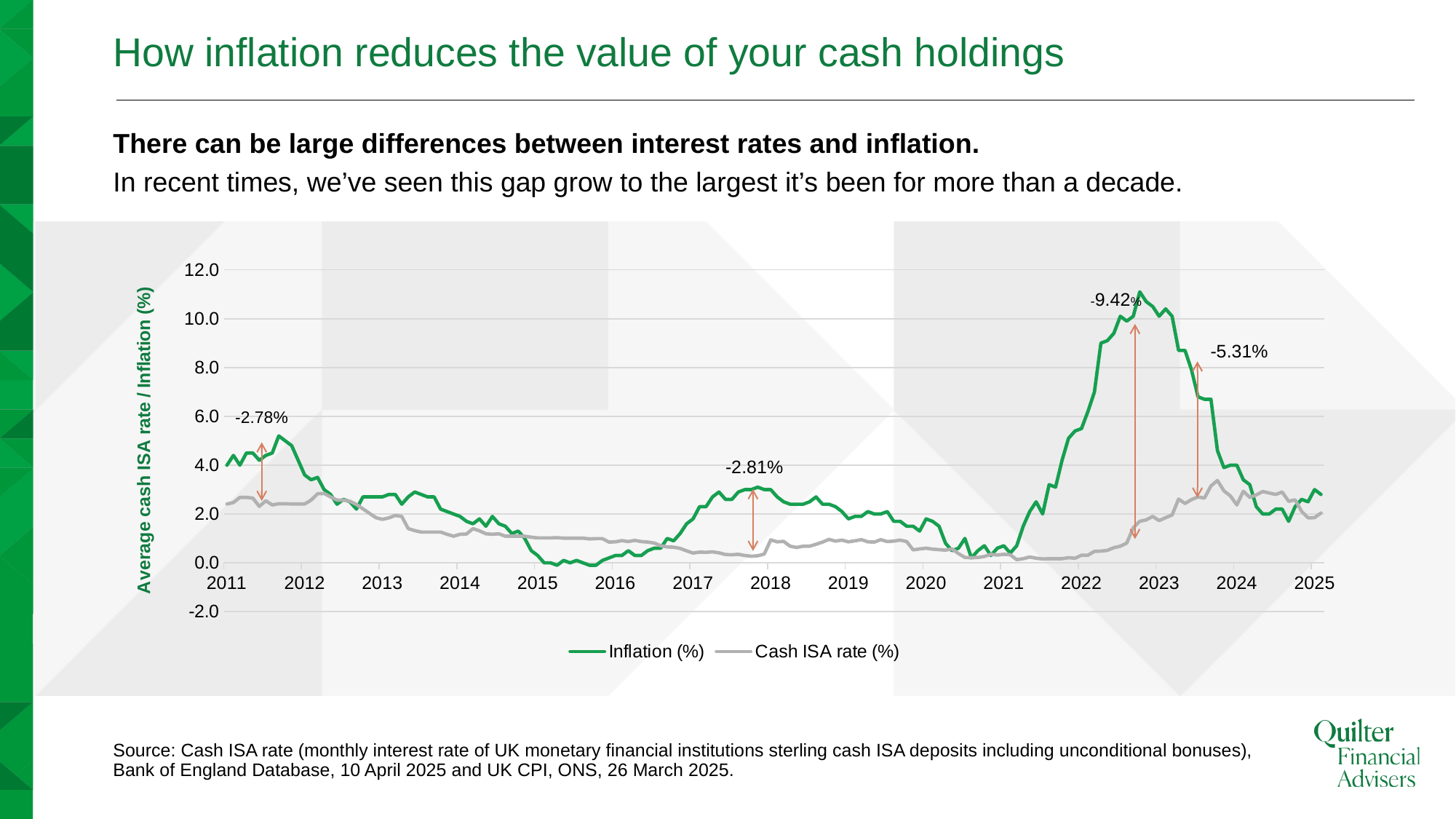
Which annotated gap between inflation and the cash ISA rate is the largest in magnitude? -9.42% How many series does the chart legend list? 2 Is the peak value of the Inflation (%) line in late 2022 greater or less than 10.0? greater What are the two series named in the chart legend? Inflation (%) and Cash ISA rate (%) How many gap annotations with arrows are marked on the chart? 4 What gap value is annotated near 2011 on the chart? -2.78% What gap value is annotated near the inflation peak around 2022-2023? -9.42% What is the label on the vertical axis of the chart? Average cash ISA rate / Inflation (%) In 2022, which line is higher: Inflation (%) or Cash ISA rate (%)? Inflation (%) What gap value is annotated near 2018 on the chart? -2.81% What type of chart is shown on the slide? Line chart What gap value is annotated near 2023-2024, after the inflation peak? -5.31%